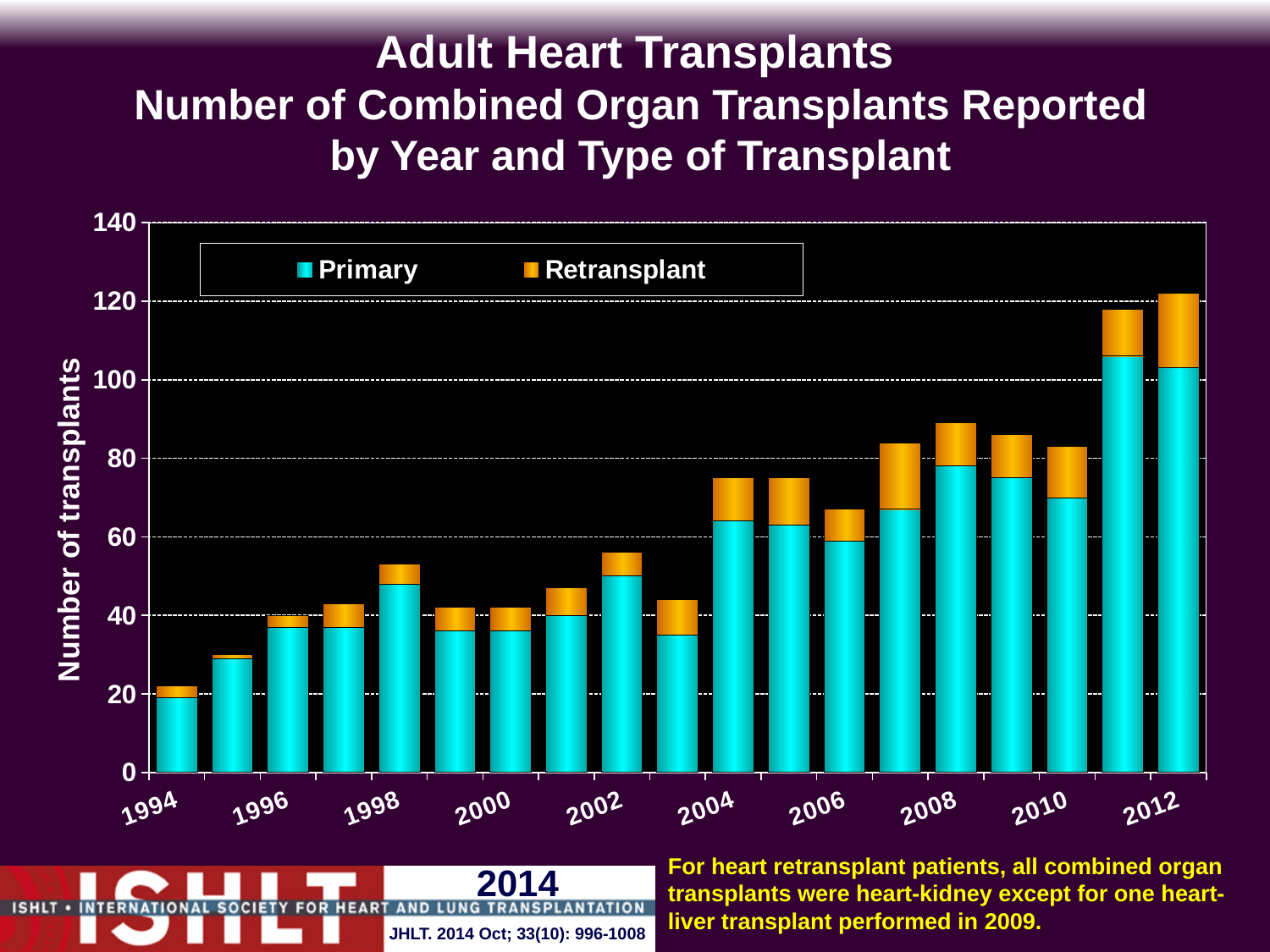
How many years (bars) are plotted on the chart? 19 Overall, do the total numbers of combined organ transplants rise or fall from 1994 to 2012? rise What are the two series named in the legend? Primary and Retransplant Is the total number of transplants for 2004 greater or less than 60? greater How many series does the legend list? 2 Is the total number of transplants for 2012 greater or less than 100? greater Which year has the highest total number of combined organ transplants? 2012 Which year has the lowest total number of combined organ transplants? 1994 Which year has a larger total number of transplants, 2003 or 2004? 2004 Is the total number of transplants for 2003 greater or less than 60? less What kind of chart is shown on the slide? Stacked bar chart